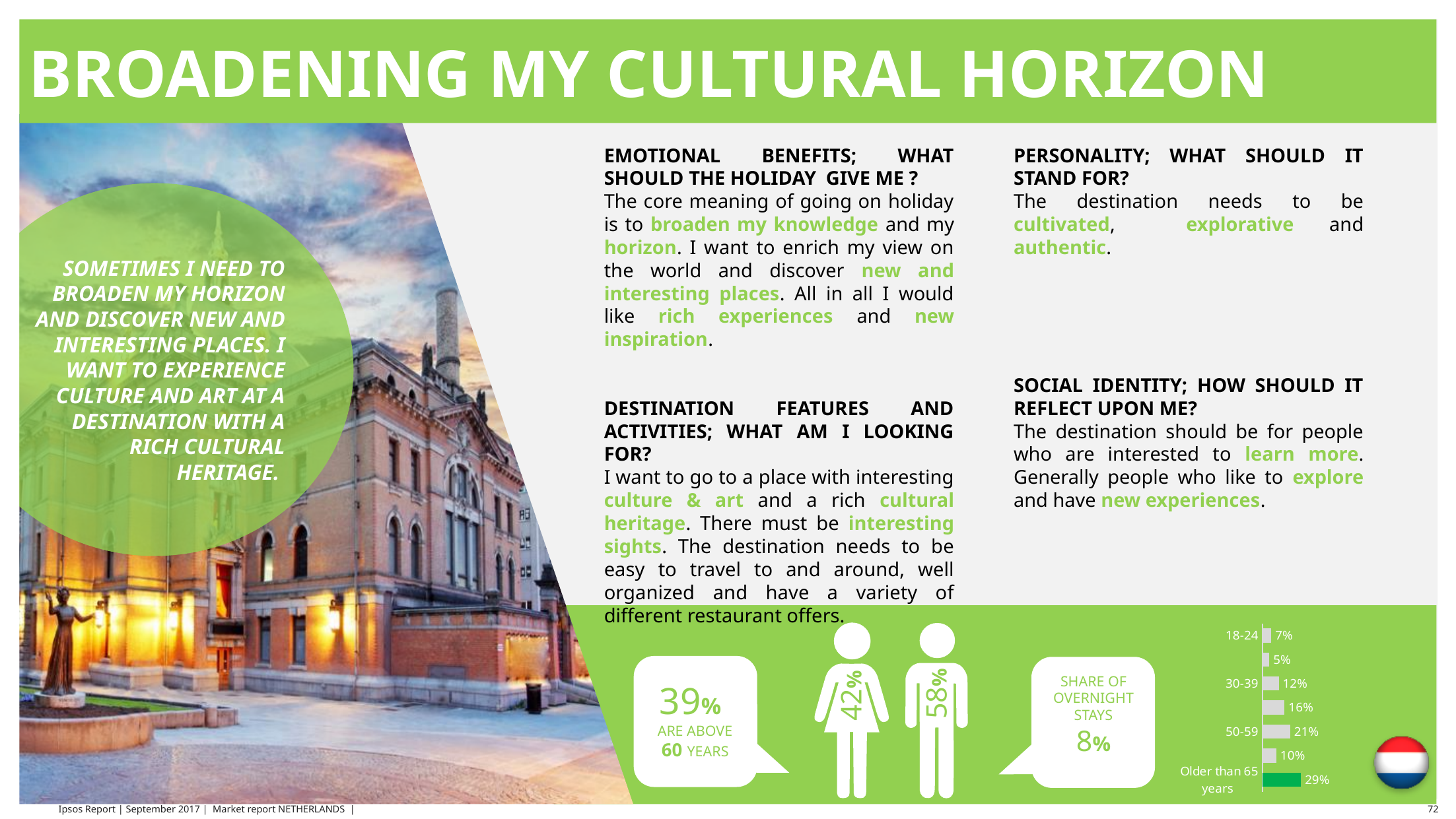
In the age-group bar chart, which is larger: the value for 50-59 or the value for 30-39? 50-59 What kind of chart is shown in the bottom right of the slide? bar chart In the age-group bar chart, what is the value for the 18-24 group? 7% In the age-group bar chart, what is the difference between the 30-39 value and the 18-24 value? 5% In the age-group bar chart, what is the value for the 50-59 group? 21% In the age-group bar chart, which labelled age group has the highest value? Older than 65 years In the age-group bar chart, which bar is coloured green rather than grey? Older than 65 years How many bars are plotted in the age-group bar chart? 7 In the age-group bar chart, what is the value for the 30-39 group? 12% In the age-group bar chart, what is the difference between the 'Older than 65 years' value and the 50-59 value? 8% In the age-group bar chart, which labelled age group has the lowest value? 18-24 In the age-group bar chart, what is the value for the 'Older than 65 years' group? 29%